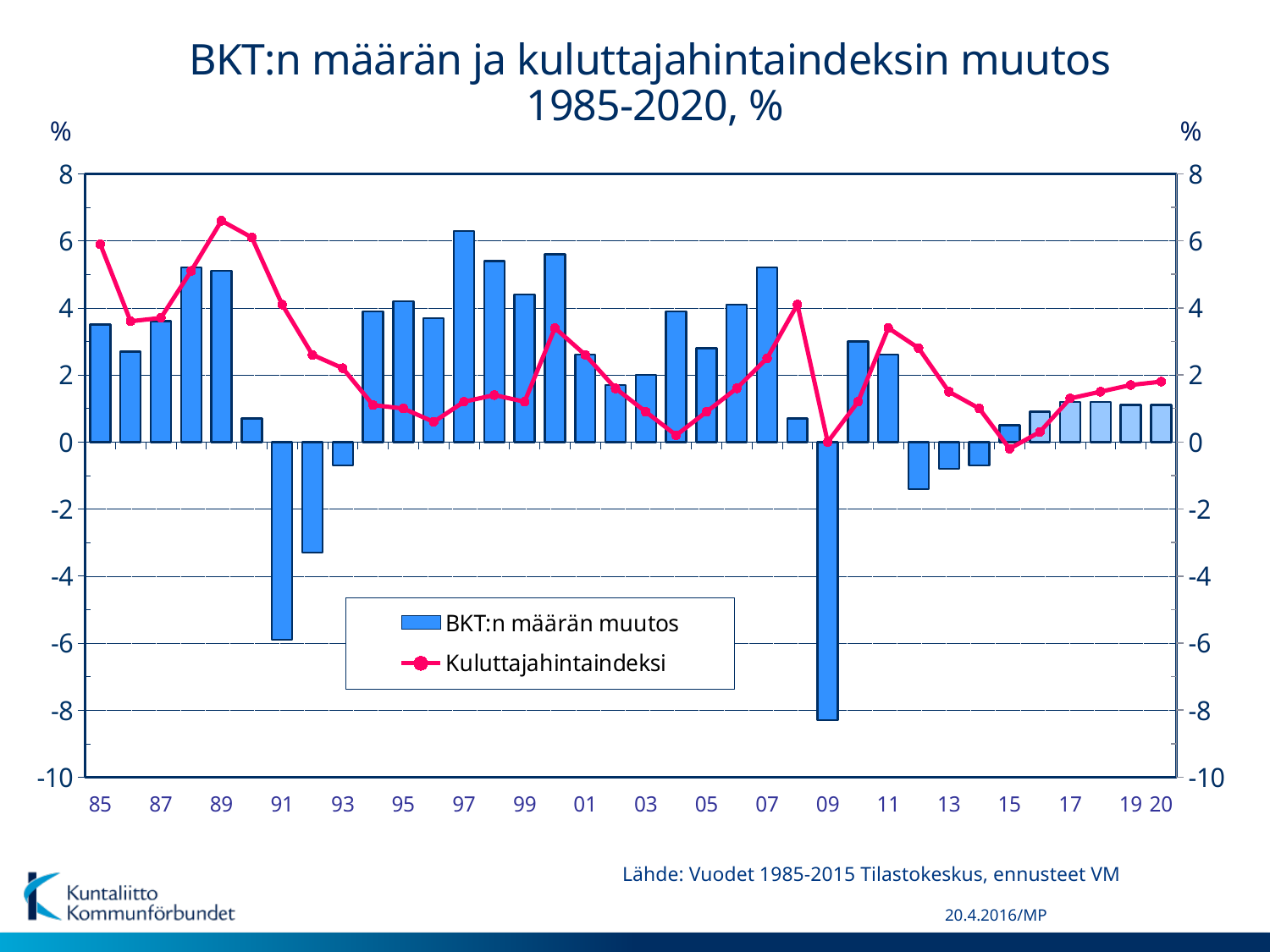
Is the BKT:n määrän muutos value for 1991 greater or less than -4? less Which year has the larger BKT:n määrän muutos bar, 1988 or 1990? 1988 What kind of chart is shown on the slide? A combined bar and line chart In which year is the BKT:n määrän muutos bar the lowest? 2009 Is the BKT:n määrän muutos value for 2009 greater or less than -6? less In which year is the BKT:n määrän muutos bar the highest? 1997 In which year does the Kuluttajahintaindeksi line reach its highest point? 1989 What are the two series named in the legend? BKT:n määrän muutos and Kuluttajahintaindeksi Does the Kuluttajahintaindeksi line rise or fall from 1989 to 1996? fall Is the Kuluttajahintaindeksi value for 1985 greater or less than 4? greater How many series does the legend list? 2